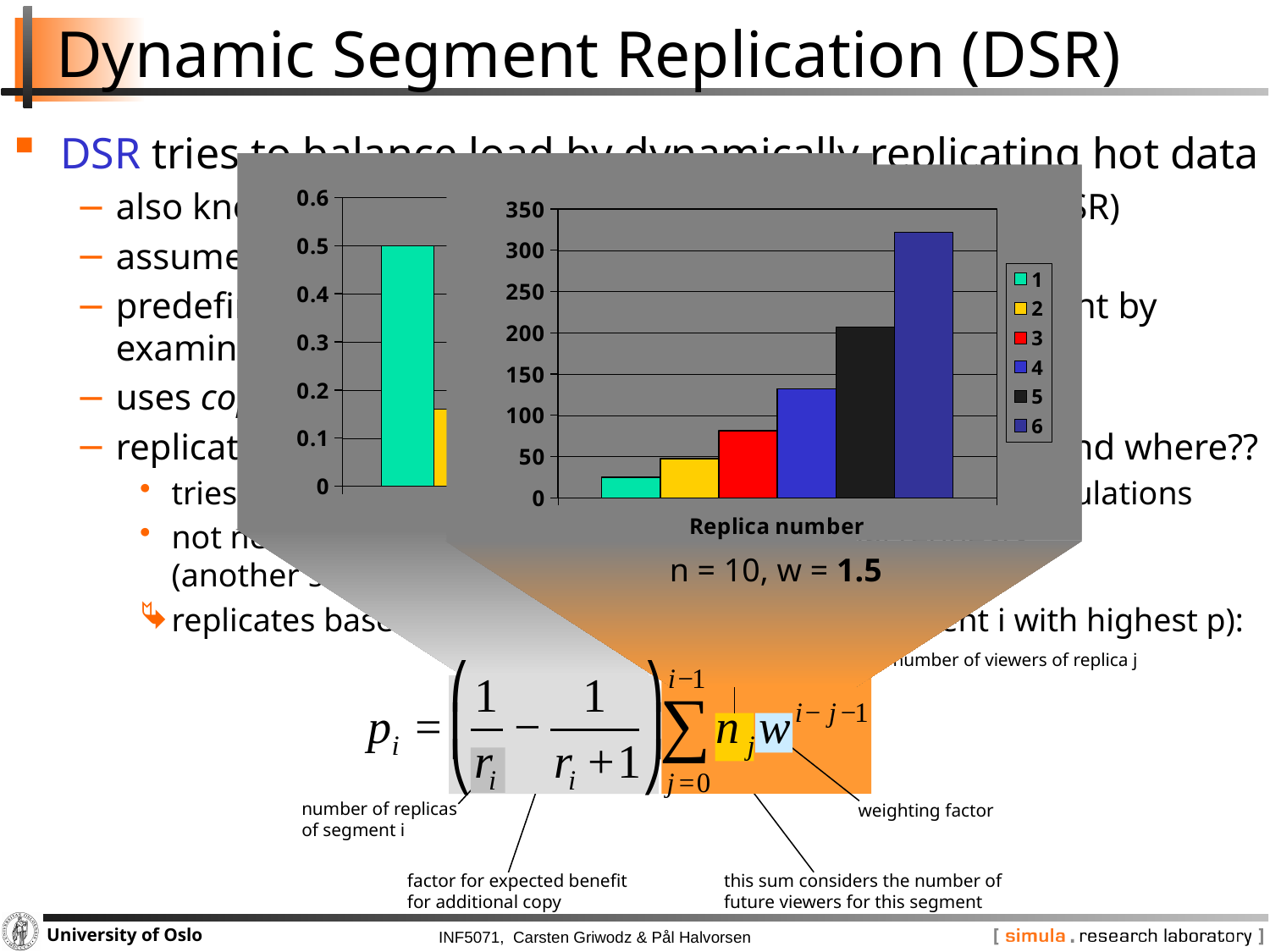
In the chart with the x-axis "Replica number", which replica number has the highest bar? 6 In the chart with the x-axis "Replica number", how many bars are plotted? 6 In the chart with the x-axis "Replica number", what colour is the bar for replica 3? red In the chart with the x-axis "Replica number", how many series does the legend list? 6 In the chart with the x-axis "Replica number", is the value for replica 5 greater or less than 250? less What kind of chart is the larger chart with the x-axis labelled "Replica number"? bar chart In the smaller chart on the left with a y-axis from 0 to 0.6, is the value of the teal bar greater or less than 0.4? greater In the chart with the x-axis "Replica number", which is larger, the value for replica 4 or the value for replica 3? replica 4 In the chart with the x-axis "Replica number", is the value for replica 6 greater or less than 300? greater In the chart with the x-axis "Replica number", do the bar values rise or fall as the replica number increases from 1 to 6? rise In the chart with the x-axis "Replica number", which replica number has the lowest bar? 1